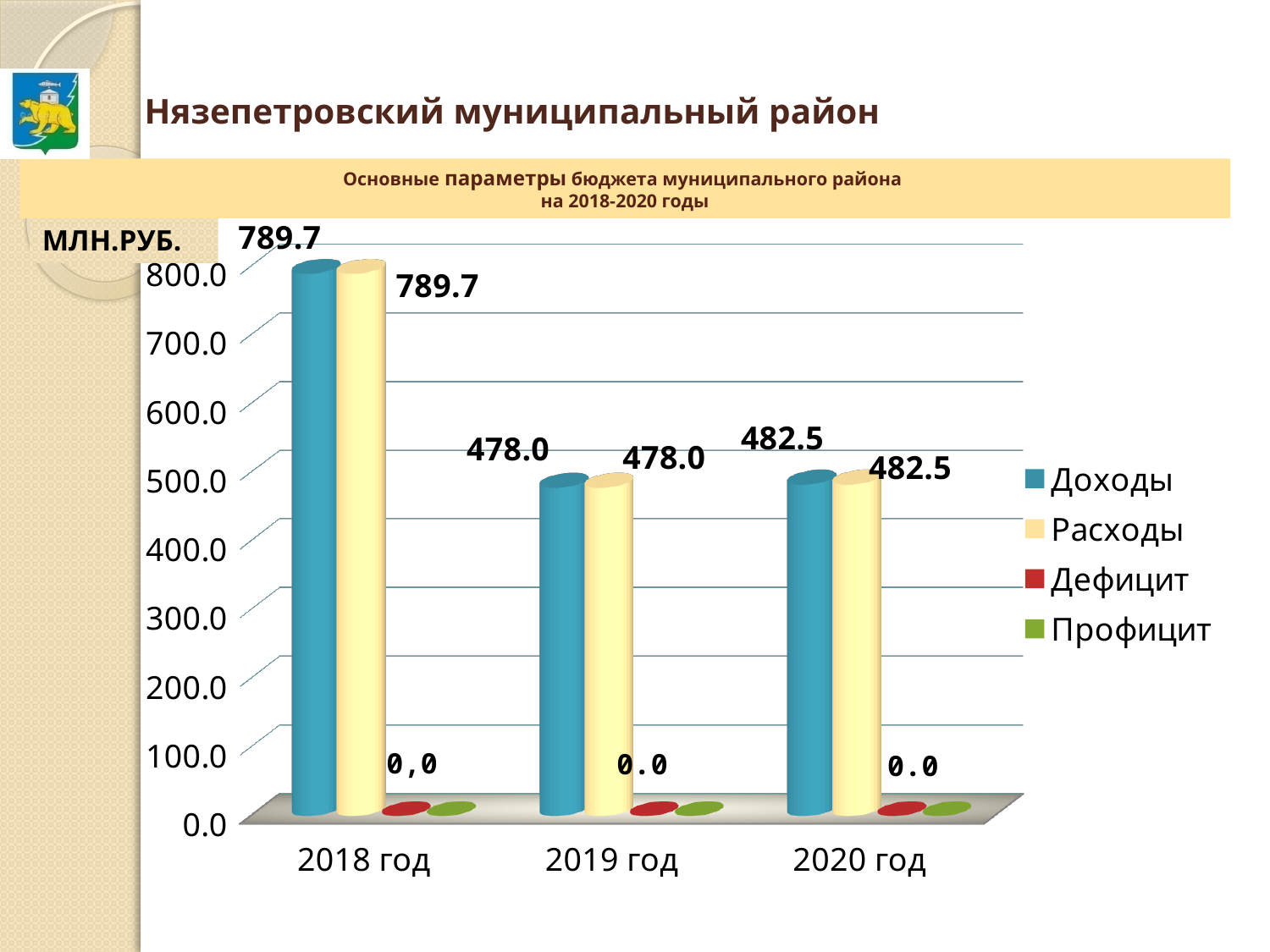
Which is larger: Доходы in 2018 год or Доходы in 2020 год? Доходы in 2018 год What is the difference between Расходы in 2020 год and Расходы in 2019 год? 4.5 What is the difference between Доходы in 2018 год and Доходы in 2019 год? 311.7 How many years are shown on the x axis? 3 What unit is indicated for the values on the chart? МЛН.РУБ. What is the value of Доходы for 2018 год? 789.7 How many series does the legend list? 4 In which year is Расходы lowest? 2019 год What kind of chart is shown on the slide? Bar chart What is the value of Доходы for 2020 год? 482.5 In which year is Доходы highest? 2018 год What is the value of Расходы for 2019 год? 478.0